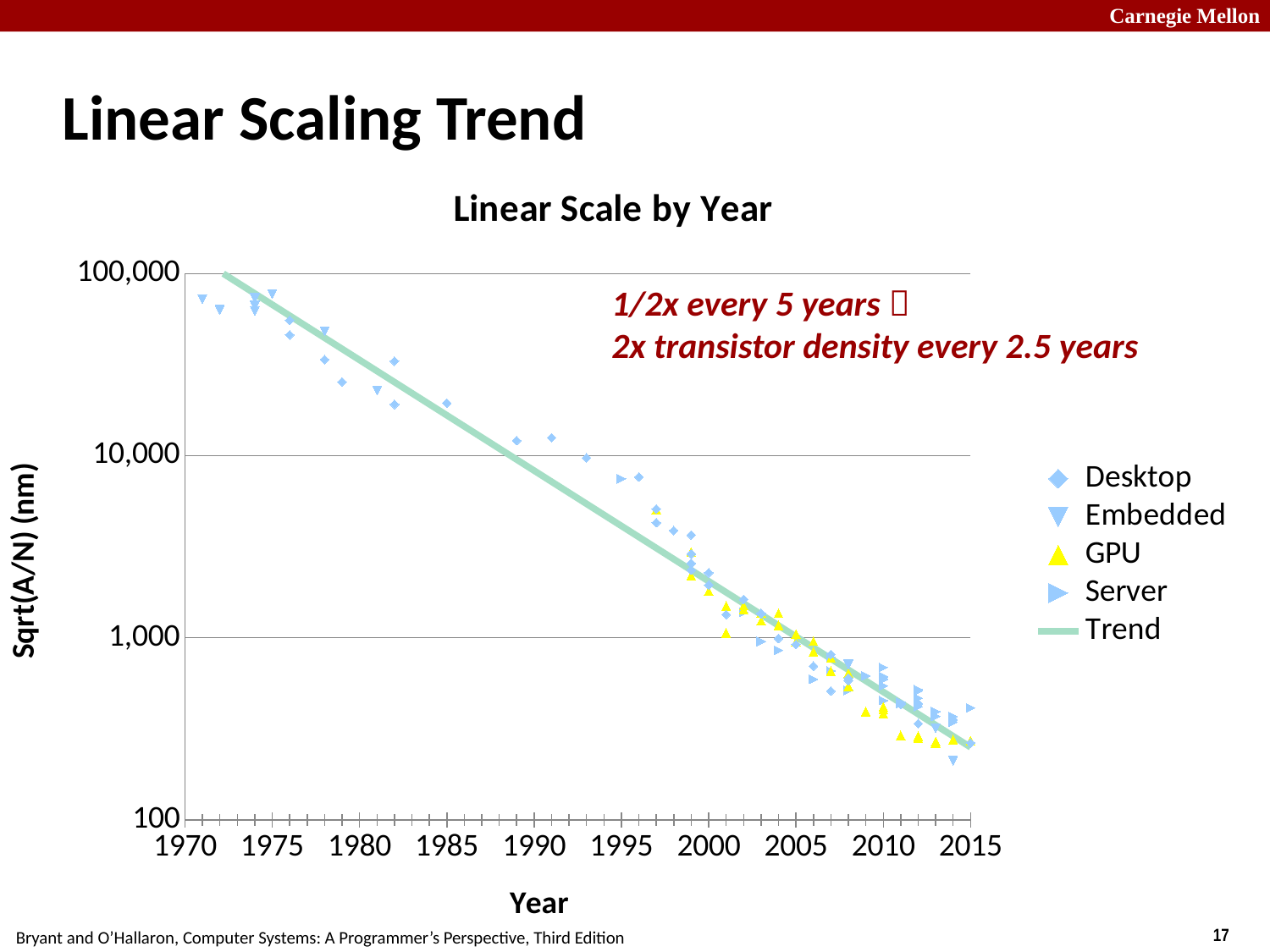
Are the Desktop values plotted around 1975 greater or less than 10,000? greater How many series does the legend list? 5 Are the GPU values plotted around 2013 greater or less than 1,000? less Are the Server values plotted around 2003 greater or less than 10,000? less Which series is drawn as a line rather than as markers? Trend Do the plotted values rise or fall as the year increases along the x axis? fall What is the title of the chart? Linear Scale by Year What is the label of the y axis? Sqrt(A/N) (nm) What kind of chart is shown on the slide? scatter chart